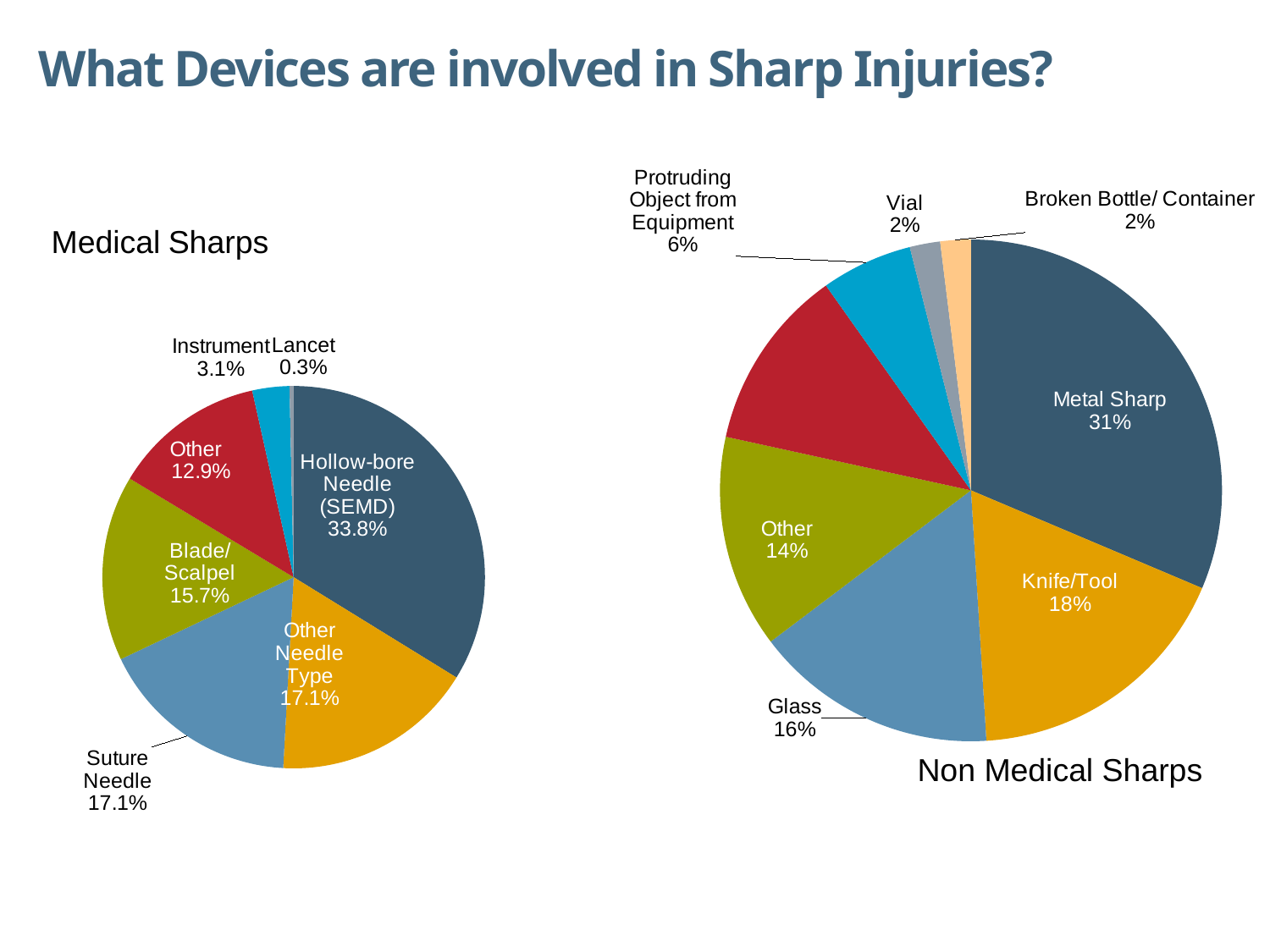
In the Non Medical Sharps pie chart, what is the difference in percentage points between Metal Sharp and Knife/Tool? 13 In the Medical Sharps pie chart, what is the difference in percentage points between Hollow-bore Needle (SEMD) and Other? 20.9 In the Non Medical Sharps pie chart, what percentage is shown for Protruding Object from Equipment? 6% In the Medical Sharps pie chart, which category has the smallest share? Lancet In the Medical Sharps pie chart, which category has the largest share? Hollow-bore Needle (SEMD) In the Non Medical Sharps pie chart, what percentage is shown for Metal Sharp? 31% What type of chart is used for the Medical Sharps data? Pie chart In the Medical Sharps pie chart, what share of injuries is attributed to Hollow-bore Needle (SEMD)? 33.8% In the Non Medical Sharps pie chart, which is larger, Knife/Tool or Glass? Knife/Tool In the Medical Sharps pie chart, what percentage is shown for Blade/Scalpel? 15.7% How many categories are shown in the Medical Sharps pie chart? 7 What is the title of the slide containing the two pie charts? What Devices are involved in Sharp Injuries?